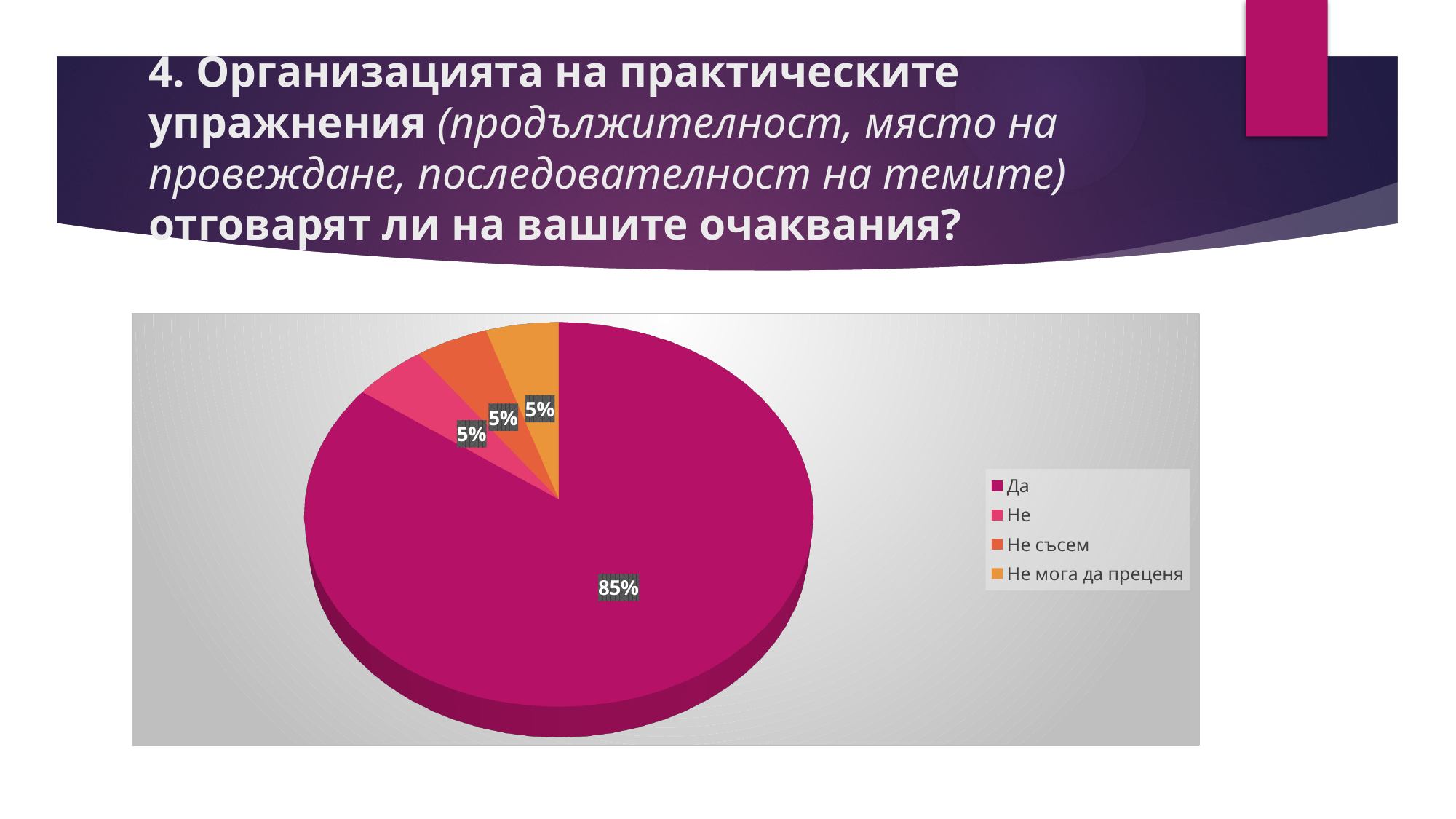
Which legend entry is listed last in the chart legend? Не мога да преценя What share of the pie does the "Да" slice represent? 85% How many slices does the pie chart have? 4 What percentage of the pie chart is labelled "Да"? 85% What is the difference in percentage points between the "Да" slice and the "Не" slice? 80 What percentage of the pie chart is labelled "Не мога да преценя"? 5% What kind of chart is shown on the slide? Pie chart What percentage of the pie chart is labelled "Не съсем"? 5% Which category has the largest slice of the pie chart? Да How many entries does the chart legend list? 4 Which slice is larger, "Да" or "Не съсем"? Да How many slices of the pie chart are labelled 5%? 3